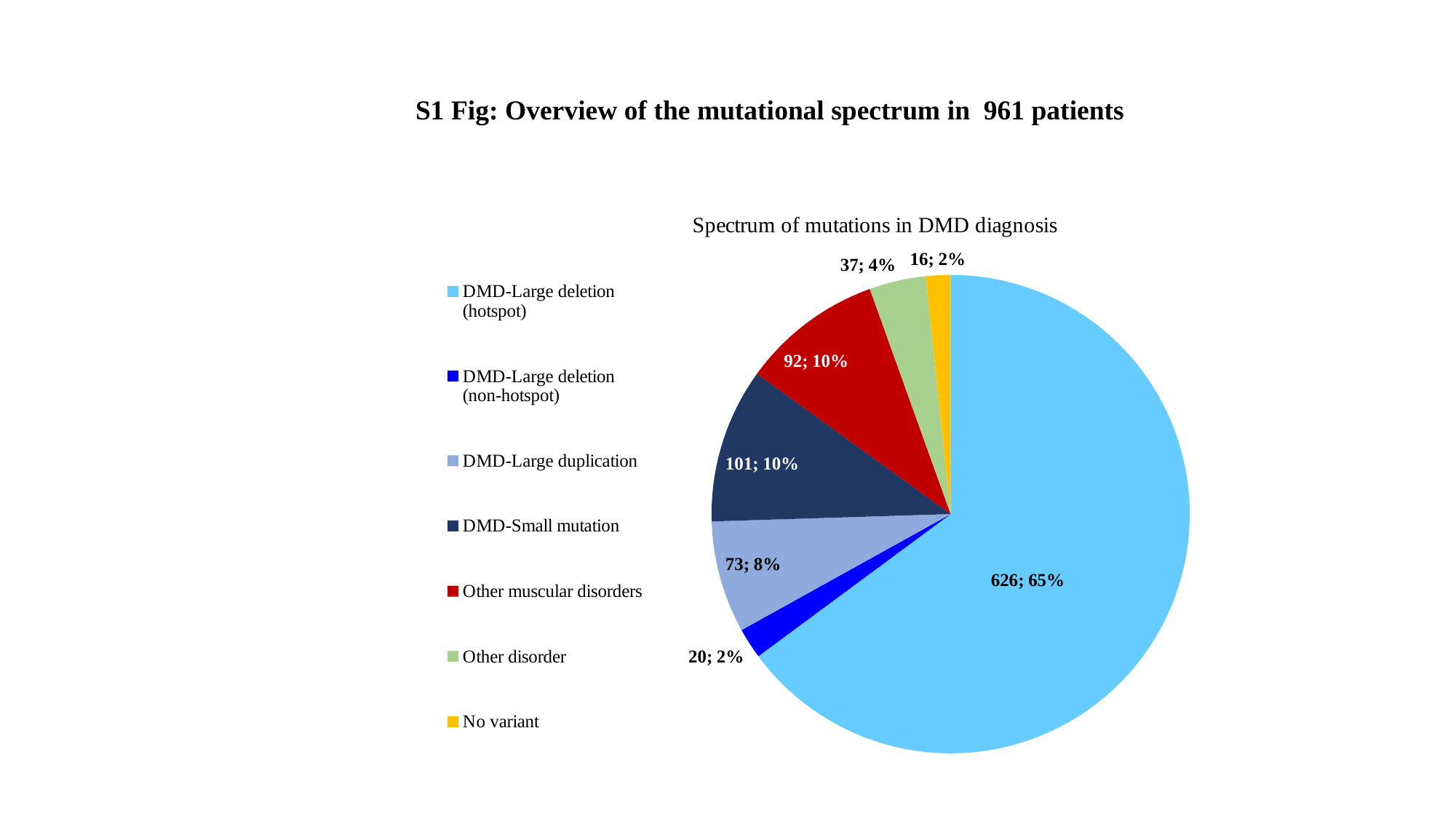
What kind of chart is shown on the slide? pie chart How many patients are in the DMD-Small mutation category? 101 Which category has the largest slice of the pie? DMD-Large deletion (hotspot) What share of the pie does DMD-Large deletion (hotspot) represent? 65% What colour is the slice for Other muscular disorders? red What is the chart title shown above the pie? Spectrum of mutations in DMD diagnosis What is the difference in patient count between DMD-Small mutation and Other muscular disorders? 9 How many categories does the legend list? 7 Which has more patients, DMD-Large duplication or Other disorder? DMD-Large duplication How many patients are in the DMD-Large deletion (hotspot) category? 626 What share of the pie does DMD-Large duplication represent? 8% Which category has the smallest slice of the pie? No variant